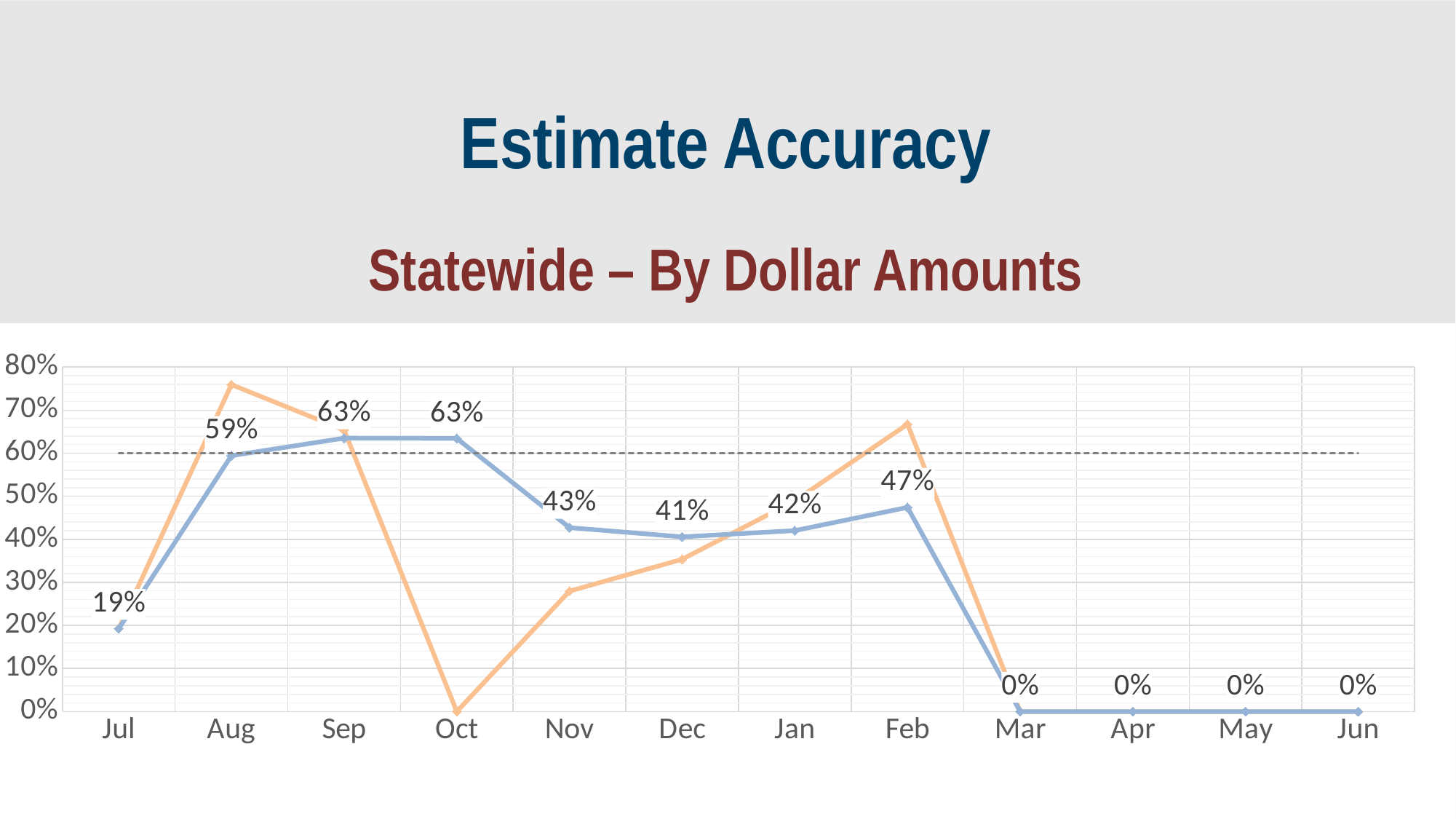
How many months are plotted along the x axis? 12 At what percentage is the horizontal dashed reference line drawn? 60% Is the value of the orange line for Aug greater or less than 70%? greater Is the value of the orange line for Oct greater or less than 10%? less What kind of chart is shown on the slide? line chart Does the blue line rise or fall from Feb to Mar? fall What is the labelled value of the blue line for Aug? 59% What is the labelled value of the blue line for Feb? 47% What is the labelled value of the blue line for Jul? 19% What is the difference between the blue line's labelled values for Sep and Nov? 20 percentage points On the blue line, which month has the larger labelled value, Nov or Dec? Nov How many months show a labelled value of 0% on the blue line? 4